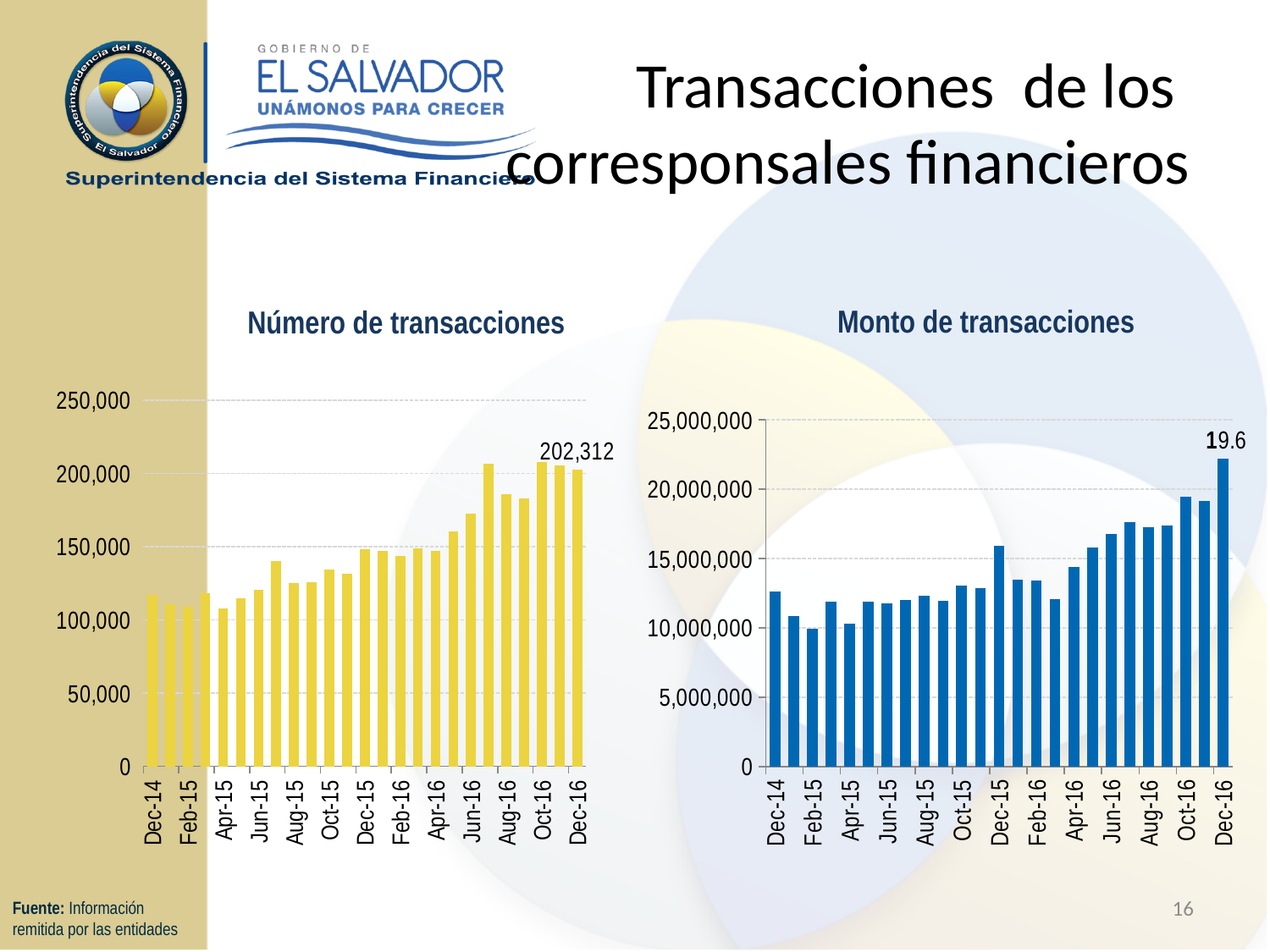
In the 'Monto de transacciones' chart, which month has the highest value? Dec-16 How many bars are plotted in the 'Número de transacciones' chart? 25 In the 'Número de transacciones' chart, is the value for Jun-16 greater or less than 150,000? greater What is the title of the chart on the left side of the slide? Número de transacciones In the 'Número de transacciones' chart, what is the value for Dec-16? 202,312 In the 'Monto de transacciones' chart, do the values generally rise or fall from Dec-14 to Dec-16? rise What colour are the bars in the 'Monto de transacciones' chart? blue In the 'Número de transacciones' chart, is the value for Dec-14 greater or less than 150,000? less What kind of chart is the 'Número de transacciones' chart? bar chart In the 'Monto de transacciones' chart, which is larger, the value for Dec-14 or the value for Dec-16? Dec-16 In the 'Monto de transacciones' chart, is the value for Feb-16 greater or less than 15,000,000? less